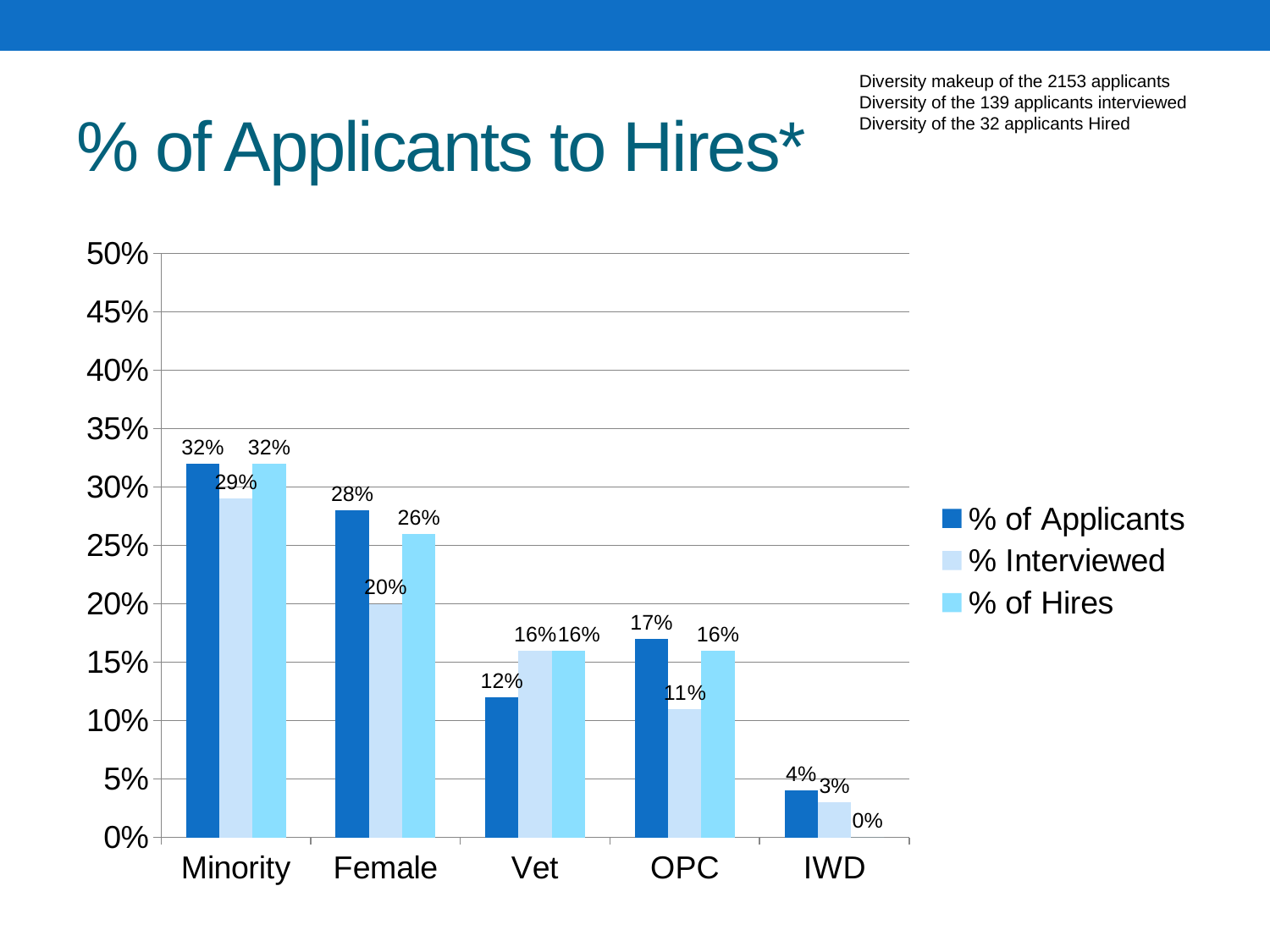
Which is larger for Vet: % of Applicants or % Interviewed? % Interviewed What is the % of Hires value for IWD? 0% What is the % of Hires value for OPC? 16% What is the % Interviewed value for Female? 20% What is the % of Applicants value for Minority? 32% What is the title of the chart on the slide? % of Applicants to Hires* How many series does the legend list? 3 Which category has the lowest % Interviewed value? IWD How many categories are shown on the x axis? 5 Which category has the highest % of Applicants value? Minority What is the difference between the % of Applicants and % Interviewed values for OPC? 6% What kind of chart is shown on the slide? Bar chart